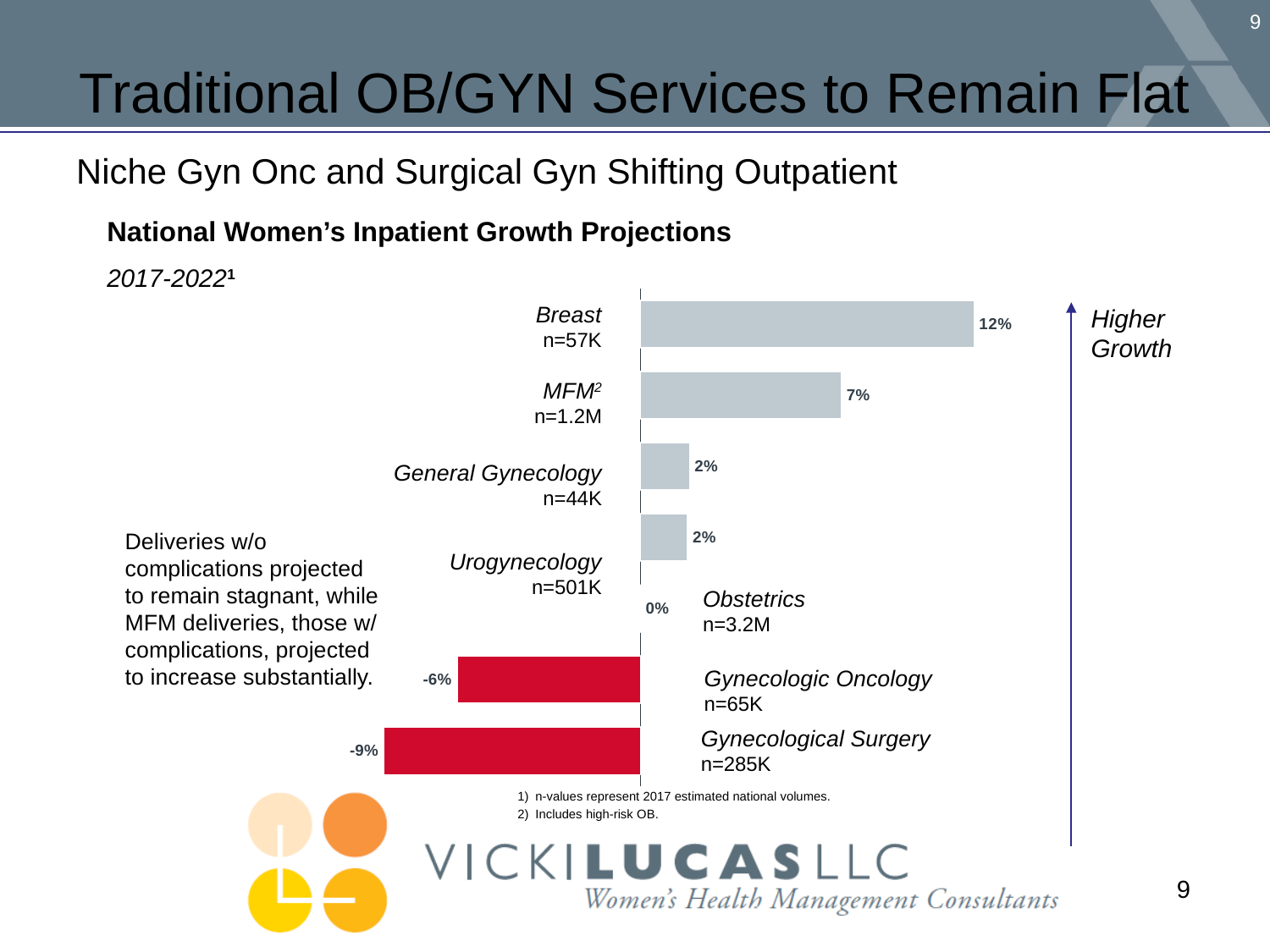
What is the projected growth for Obstetrics? 0% What is the difference between the projected growth for Gynecologic Oncology and Gynecological Surgery? 3% What is the title of the chart? National Women's Inpatient Growth Projections What is the projected growth for Gynecological Surgery? -9% What is the projected growth for MFM? 7% What kind of chart is shown on the slide? Bar chart Which category has the highest projected growth? Breast Which category has the lowest projected growth? Gynecological Surgery Which has a higher projected growth, MFM or General Gynecology? MFM What is the difference between the projected growth for Breast and MFM? 5% What is the projected growth for Breast? 12% How many categories are shown in the chart? 7